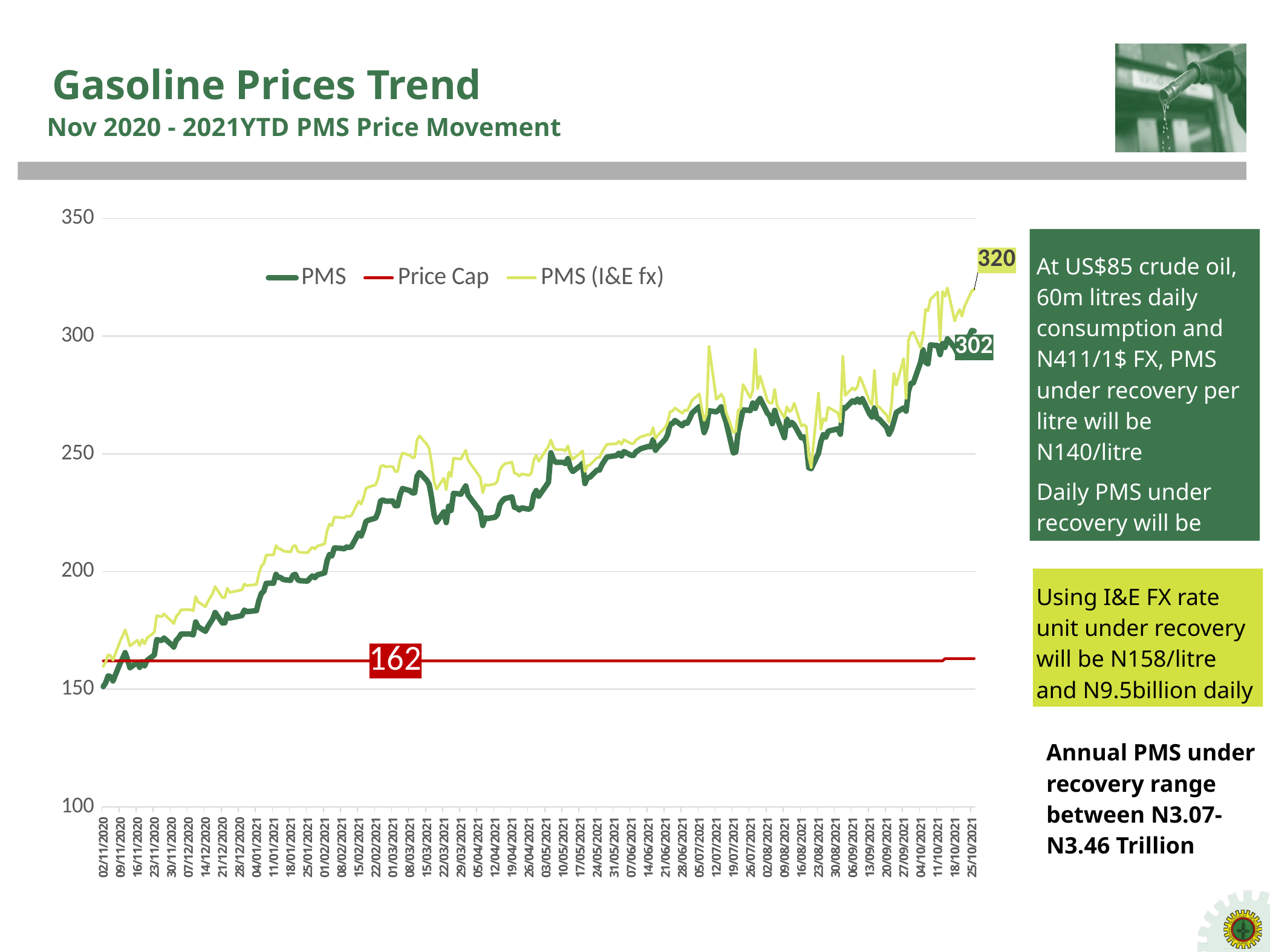
Is the PMS value at 02/11/2020 greater or less than 200? less Does the PMS series generally rise or fall from 02/11/2020 to 25/10/2021? rise What is the labelled final value of the PMS series? 302 Is the PMS value at 04/01/2021 greater or less than 250? less What value is labelled on the Price Cap line? 162 What is the labelled final value of the PMS (I&E fx) series? 320 Which series is drawn as a flat horizontal line across the chart? Price Cap What kind of chart is shown on the slide? line chart What is the difference between the labelled final values of PMS (I&E fx) and PMS? 18 At the end of the period, which is larger: the PMS (I&E fx) value or the PMS value? PMS (I&E fx) How many series does the chart legend list? 3 What is the difference between the labelled final PMS value and the Price Cap value? 140